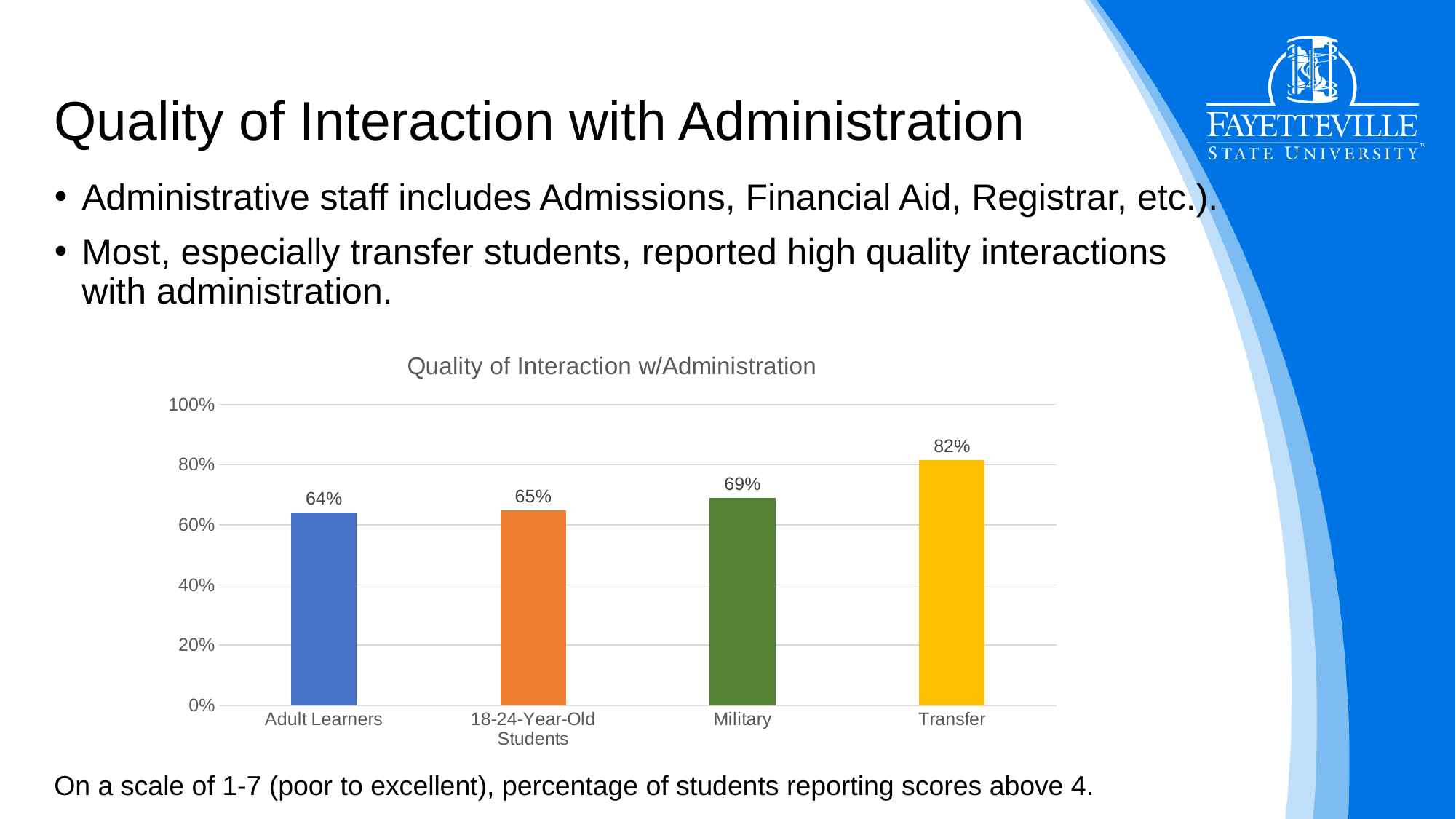
What is the value for Military? 69% Which is larger, the value for Military or the value for 18-24-Year-Old Students? Military What is the value for Adult Learners? 64% What is the difference between the values for Military and Adult Learners? 5% Which category has the lowest value? Adult Learners Which category has the highest value? Transfer What is the difference between the values for Transfer and Military? 13% What is the value for Transfer? 82% What kind of chart is shown on the slide? Bar chart What is the value for 18-24-Year-Old Students? 65% How many categories are shown in the chart? 4 Is the value for Transfer greater or less than 80%? greater